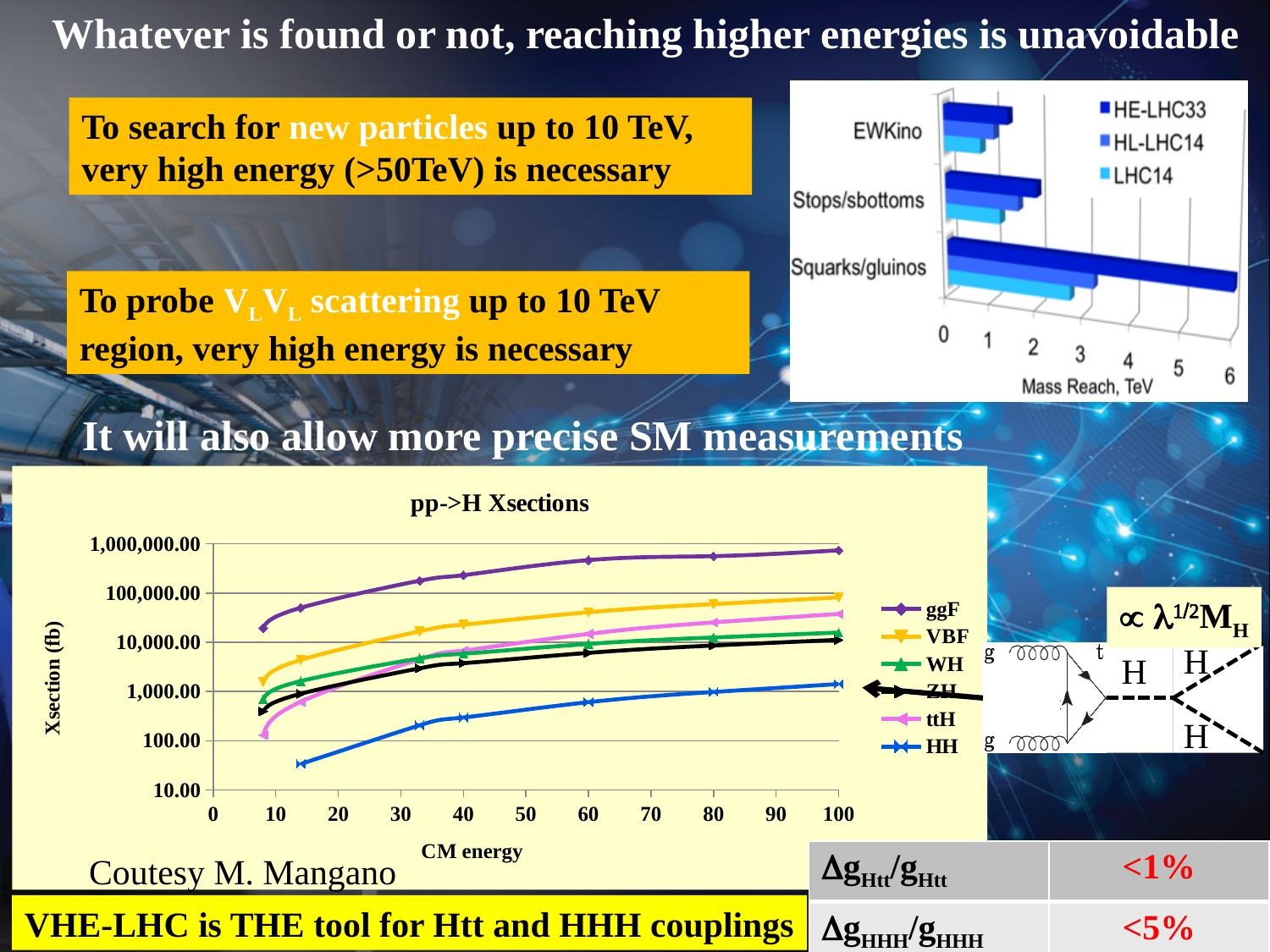
In the 'Mass Reach, TeV' bar chart, is the HE-LHC33 mass reach for Squarks/gluinos greater or less than 5 TeV? greater What kind of chart is the 'Mass Reach, TeV' chart in the top right of the slide? bar chart What is the title of the line chart at the bottom left of the slide? pp->H Xsections In the 'Mass Reach, TeV' bar chart, is the HE-LHC33 mass reach for EWKino greater or less than 2 TeV? less In the 'pp->H Xsections' chart, is the ggF cross section at CM energy 100 greater or less than 100,000.00 fb? greater In the 'Mass Reach, TeV' bar chart, which category has the highest mass reach for HE-LHC33? Squarks/gluinos In the 'pp->H Xsections' chart, which series has the lowest cross section across the CM energy range? HH How many series does the legend of the 'Mass Reach, TeV' bar chart list? 3 In the 'pp->H Xsections' chart, do the cross sections rise or fall as CM energy increases? rise In the 'pp->H Xsections' chart, which series has the highest cross section across the CM energy range? ggF How many categories does the 'Mass Reach, TeV' bar chart show? 3 How many series does the legend of the 'pp->H Xsections' chart list? 6